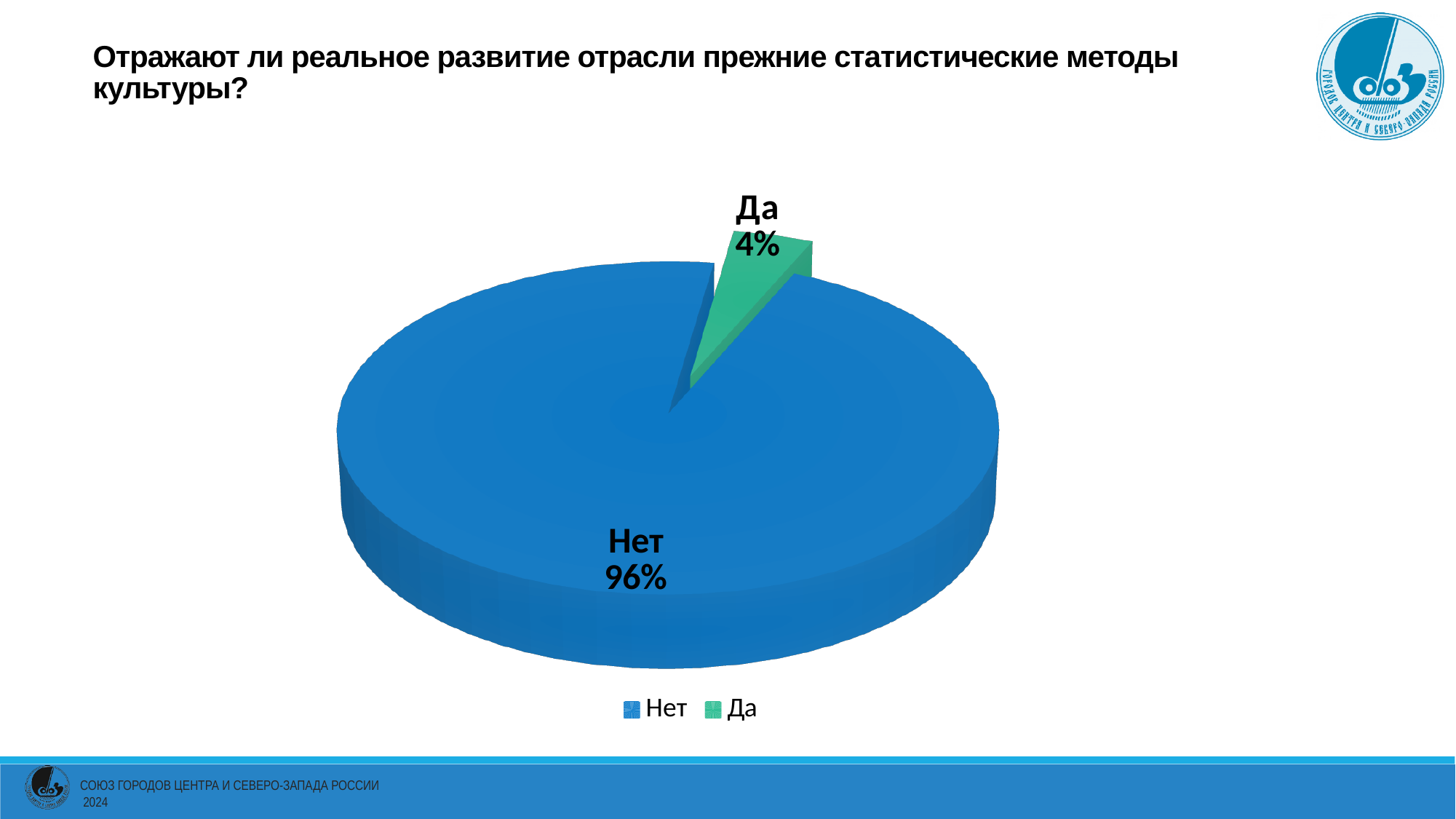
What kind of chart is shown on the slide? Pie chart Which category has the largest slice of the pie? Нет How many slices does the pie chart have? 2 What colour is the "Да" slice? Green What share of the pie does "Нет" represent? 96% Which category has the smallest slice of the pie? Да What is the difference in percentage points between the "Нет" and "Да" slices? 92 How many entries does the legend list? 2 What question does the chart title ask? Отражают ли реальное развитие отрасли прежние статистические методы культуры? Which slice is larger, "Да" or "Нет"? Нет What share of the pie does "Да" represent? 4%